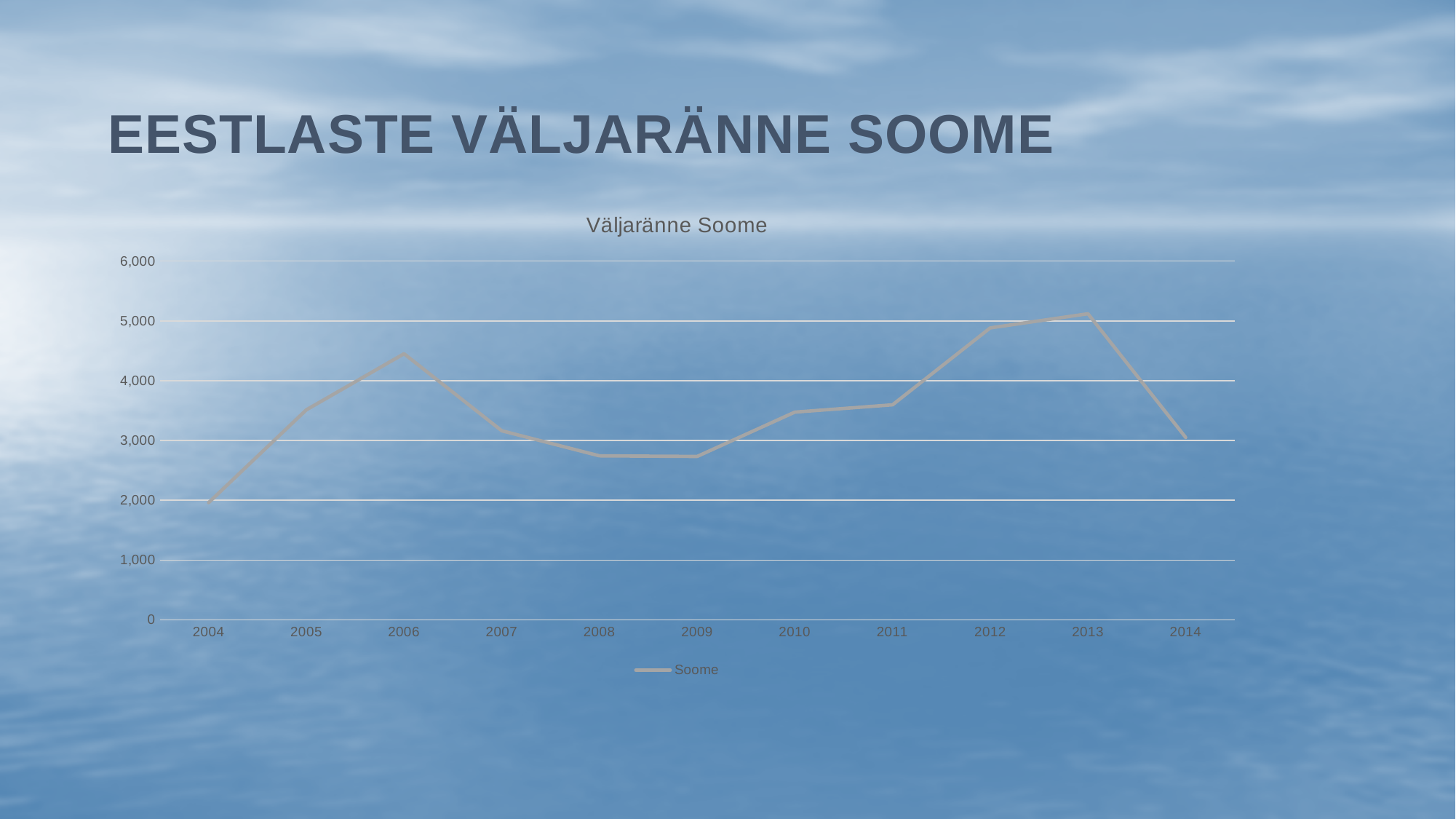
What is the name of the series shown in the legend? Soome Do the values rise or fall from 2013 to 2014? fall Is the value for 2006 greater or less than 4,000? greater How many series does the chart's legend list? 1 What kind of chart is shown on the slide? Line chart What is the title of the chart? Väljaränne Soome Is the value for 2011 greater or less than 4,000? less In which year is the value lowest? 2004 Which year has the larger value, 2006 or 2007? 2006 Is the value for 2008 greater or less than 3,000? less How many years are plotted on the x axis of the chart? 11 In which year is the value highest? 2013